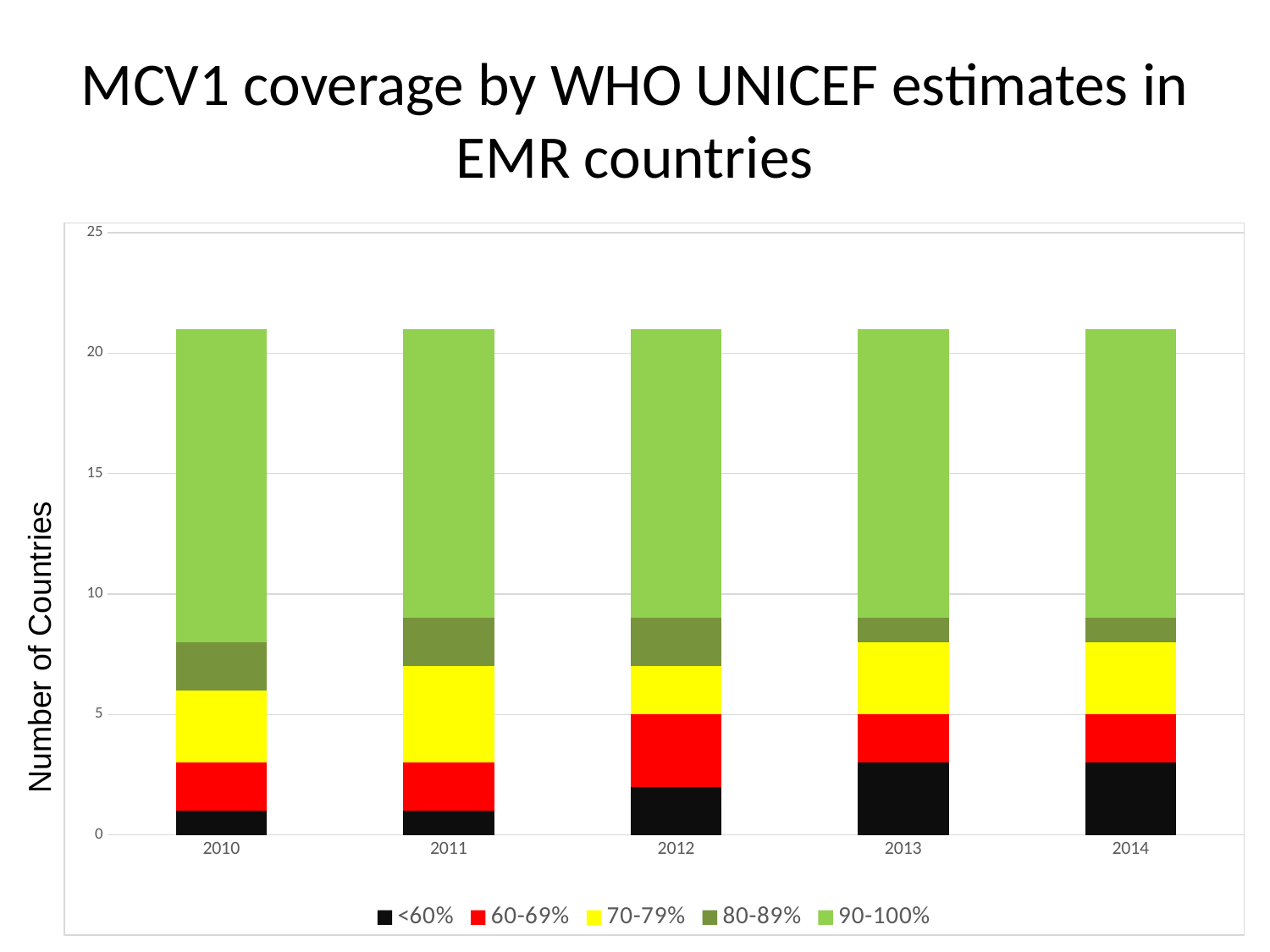
Does the <60% segment rise or fall from 2010 to 2014? rise What is the label on the y axis? Number of Countries Which series forms the largest segment in every bar? 90-100% What is the title of the chart? MCV1 coverage by WHO UNICEF estimates in EMR countries How many series does the legend list? 5 How many years are shown on the x axis? 5 What kind of chart is shown on the slide? bar chart Which is larger, the 60-69% segment for 2012 or the 60-69% segment for 2010? 2012 Is the total height of the stacked bar for 2010 greater or less than 20? greater Is the value of the <60% segment for 2014 greater or less than 5? less Which is larger, the <60% segment for 2014 or the <60% segment for 2010? 2014 Is the total height of the stacked bar for 2014 greater or less than 25? less